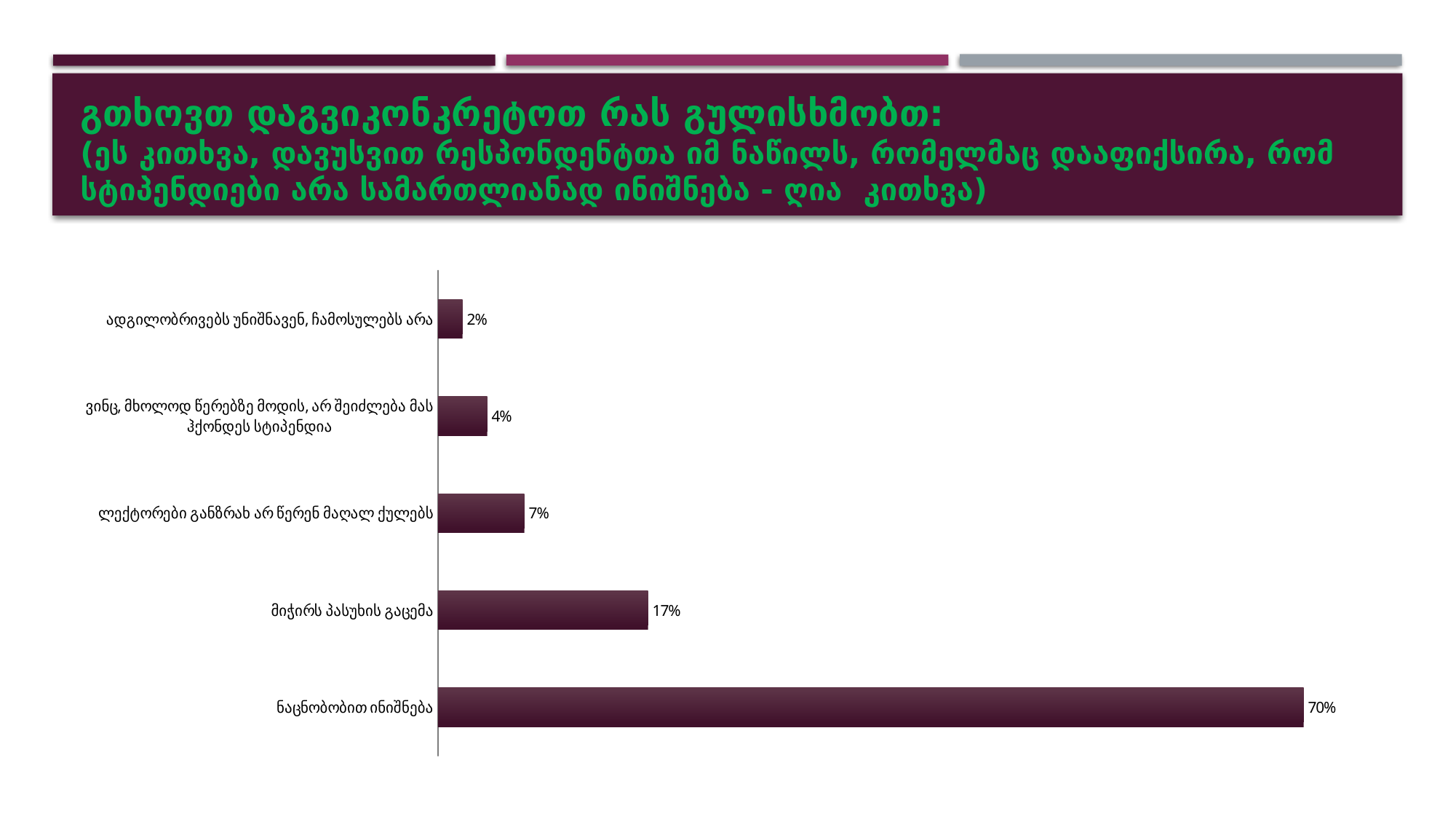
What is the difference between the values for "ნაცნობობით ინიშნება" and "მიჭირს პასუხის გაცემა"? 53% Which category has the highest value in the chart? ნაცნობობით ინიშნება What value is shown for the category "ადგილობრივებს უნიშნავენ, ჩამოსულებს არა"? 2% What value is shown for the category "ლექტორები განზრახ არ წერენ მაღალ ქულებს"? 7% What value is shown for the category "ნაცნობობით ინიშნება"? 70% What is the difference between the values for "ლექტორები განზრახ არ წერენ მაღალ ქულებს" and "ვინც, მხოლოდ წერებზე მოდის, არ შეიძლება მას ჰქონდეს სტიპენდია"? 3% What colour are the bars in the chart? Dark purple What value is shown for the category "მიჭირს პასუხის გაცემა"? 17% Which category has the lowest value in the chart? ადგილობრივებს უნიშნავენ, ჩამოსულებს არა How many categories are shown in the chart? 5 Which is larger: the value for "მიჭირს პასუხის გაცემა" or the value for "ლექტორები განზრახ არ წერენ მაღალ ქულებს"? მიჭირს პასუხის გაცემა What kind of chart is shown on the slide? Bar chart